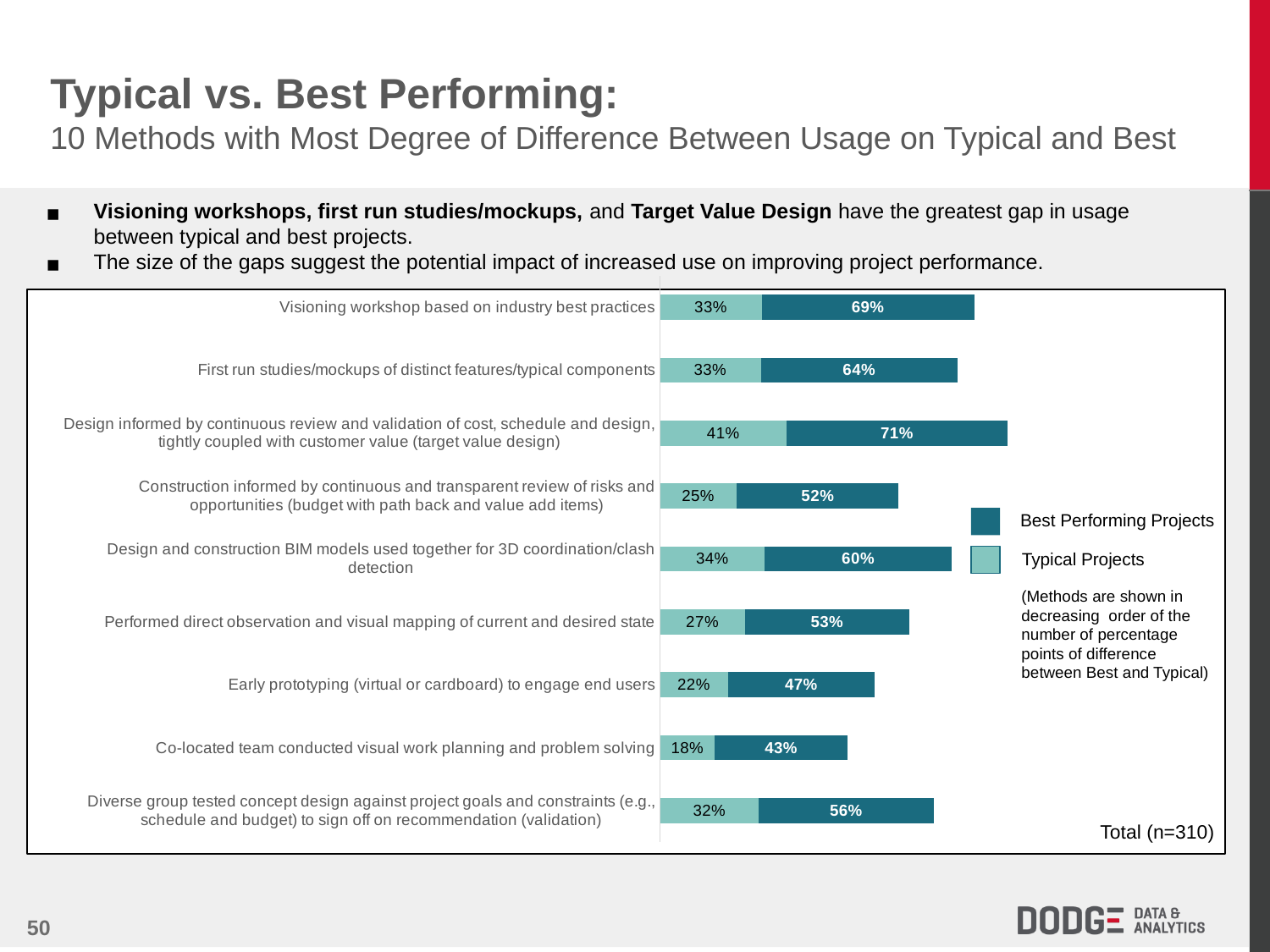
How many methods (categories) are plotted in the chart? 9 Which method has the highest Best Performing Projects value? Design informed by continuous review and validation of cost, schedule and design, tightly coupled with customer value (target value design) What is the difference between the Best Performing Projects and Typical Projects values for 'Visioning workshop based on industry best practices'? 36 percentage points Which method has the lowest Typical Projects value? Co-located team conducted visual work planning and problem solving What kind of chart is shown on the slide? bar chart What is the Best Performing Projects value for 'Visioning workshop based on industry best practices'? 69% Which is larger: the Best Performing Projects value for 'Early prototyping (virtual or cardboard) to engage end users' or for 'Performed direct observation and visual mapping of current and desired state'? Performed direct observation and visual mapping of current and desired state How many series does the legend list? 2 What is the sample size shown in the chart? Total (n=310) What is the Typical Projects value for 'Design informed by continuous review and validation of cost, schedule and design, tightly coupled with customer value (target value design)'? 41% What is the Best Performing Projects value for 'Diverse group tested concept design against project goals and constraints (e.g., schedule and budget) to sign off on recommendation (validation)'? 56% What is the Typical Projects value for 'Co-located team conducted visual work planning and problem solving'? 18%